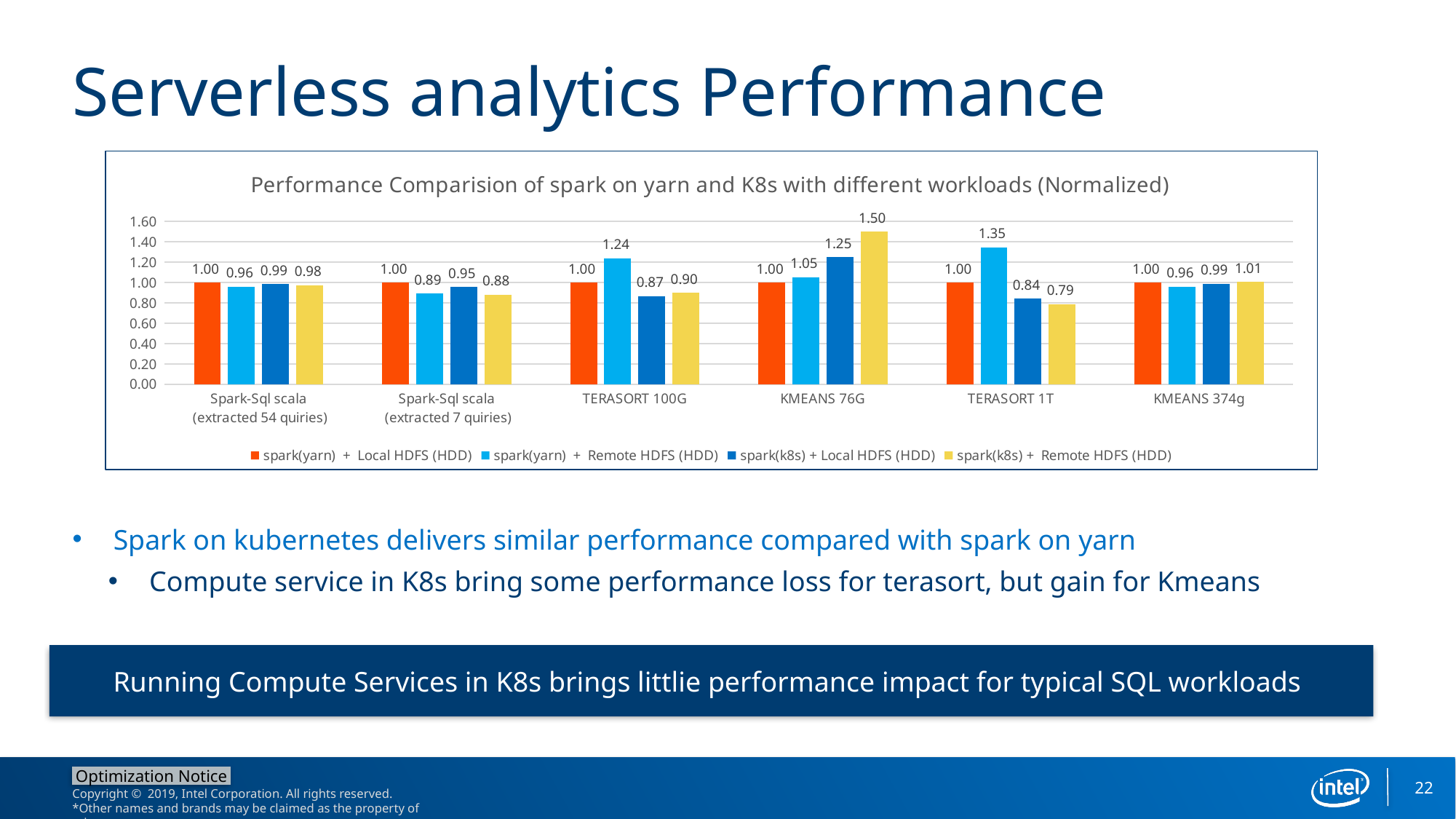
Which workload has the lowest value for spark(k8s) + Remote HDFS (HDD)? TERASORT 1T What is the value for spark(k8s) + Remote HDFS (HDD) for KMEANS 76G? 1.50 What is the value for spark(k8s) + Local HDFS (HDD) for TERASORT 100G? 0.87 Which workload has the highest value for spark(k8s) + Remote HDFS (HDD)? KMEANS 76G What type of chart is shown on the slide? bar chart What is the difference between the spark(k8s) + Remote HDFS (HDD) value and the spark(yarn) + Local HDFS (HDD) value for KMEANS 76G? 0.50 What is the title of the chart? Performance Comparision of spark on yarn and K8s with different workloads (Normalized) For TERASORT 1T, which is larger: the spark(yarn) + Remote HDFS (HDD) value or the spark(k8s) + Local HDFS (HDD) value? spark(yarn) + Remote HDFS (HDD) How many series does the chart legend list? 4 What is the value for spark(yarn) + Remote HDFS (HDD) for TERASORT 1T? 1.35 How many workload categories are shown on the x axis of the chart? 6 Is the value for spark(k8s) + Local HDFS (HDD) for KMEANS 76G greater or less than 1.20? greater